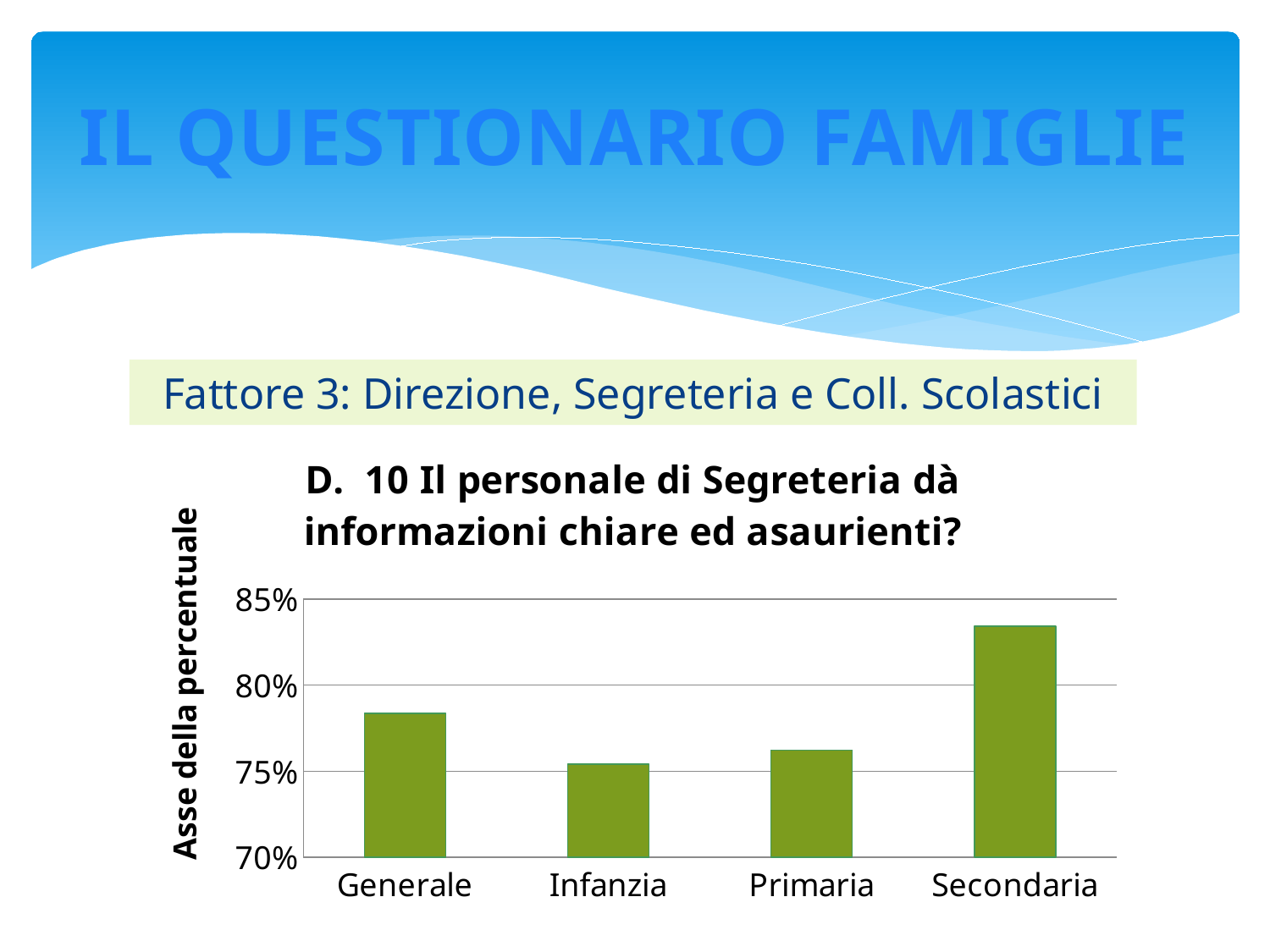
Is the value for Generale greater or less than 80%? less Is the value for Secondaria greater or less than 80%? greater What is the title of the chart? D. 10 Il personale di Segreteria dà informazioni chiare ed asaurienti? What is the label on the vertical axis of the chart? Asse della percentuale Which has a larger value, Generale or Primaria? Generale How many categories are shown on the x axis of the chart? 4 Is the value for Secondaria greater or less than 85%? less What kind of chart is shown on the slide? bar chart Which category has the lowest value in the chart? Infanzia Which category has the highest value in the chart? Secondaria Which has a larger value, Generale or Secondaria? Secondaria